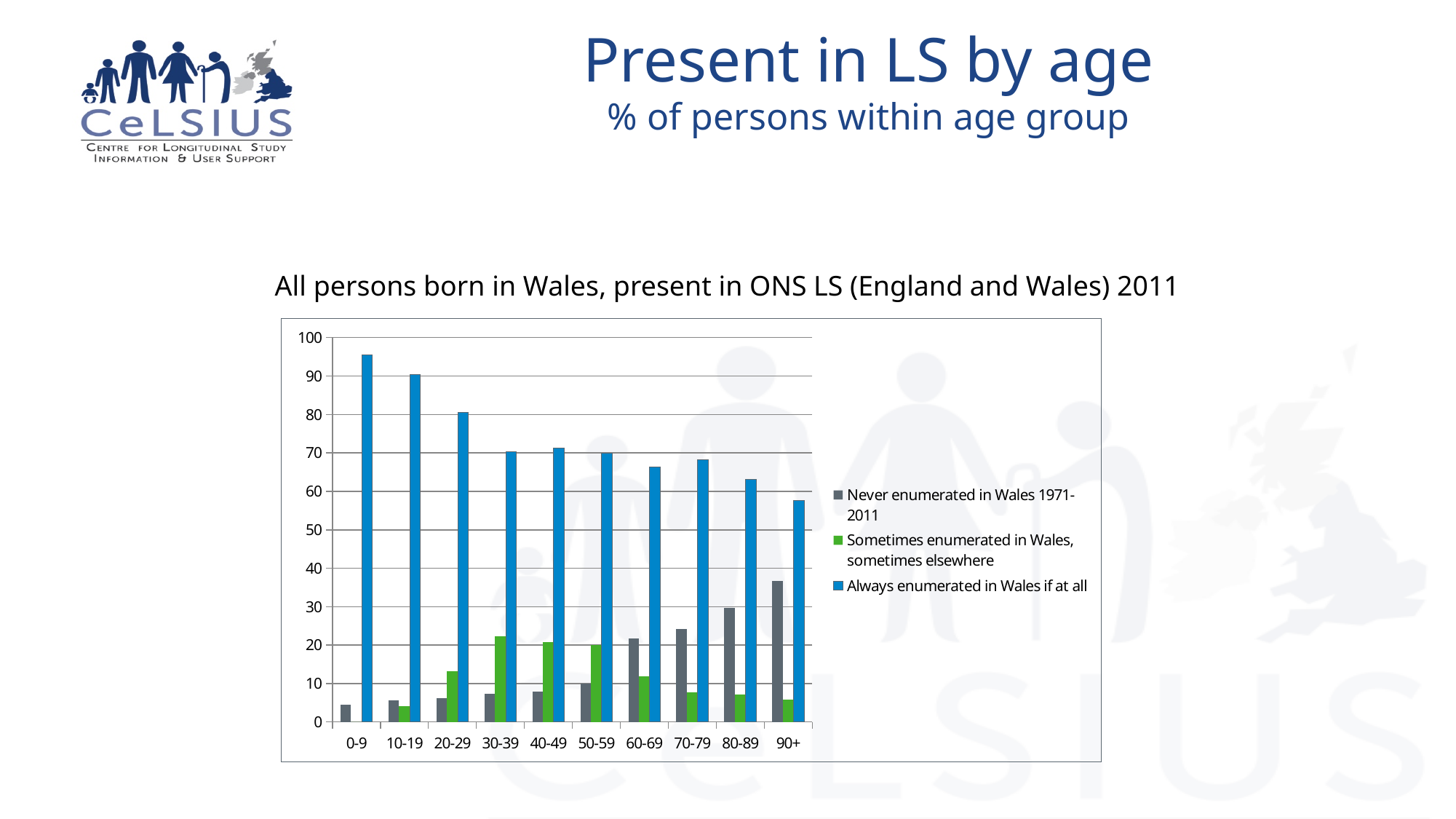
How many series does the legend list? 3 How many age groups are shown on the x axis? 10 Is the value for 'Sometimes enumerated in Wales, sometimes elsewhere' in the 20-29 age group greater or less than 10? greater Is the value for 'Always enumerated in Wales if at all' in the 0-9 age group greater or less than 90? greater Which age group has the lowest value for 'Always enumerated in Wales if at all'? 90+ Is the value for 'Never enumerated in Wales 1971-2011' in the 90+ age group greater or less than 30? greater What kind of chart is shown on the slide? bar chart Which age group has the highest value for 'Always enumerated in Wales if at all'? 0-9 In the 90+ age group, which is larger: 'Never enumerated in Wales 1971-2011' or 'Sometimes enumerated in Wales, sometimes elsewhere'? Never enumerated in Wales 1971-2011 Which age group has the highest value for 'Never enumerated in Wales 1971-2011'? 90+ What colour represents 'Always enumerated in Wales if at all' in the chart? blue Does the value for 'Always enumerated in Wales if at all' generally rise or fall as age increases? fall